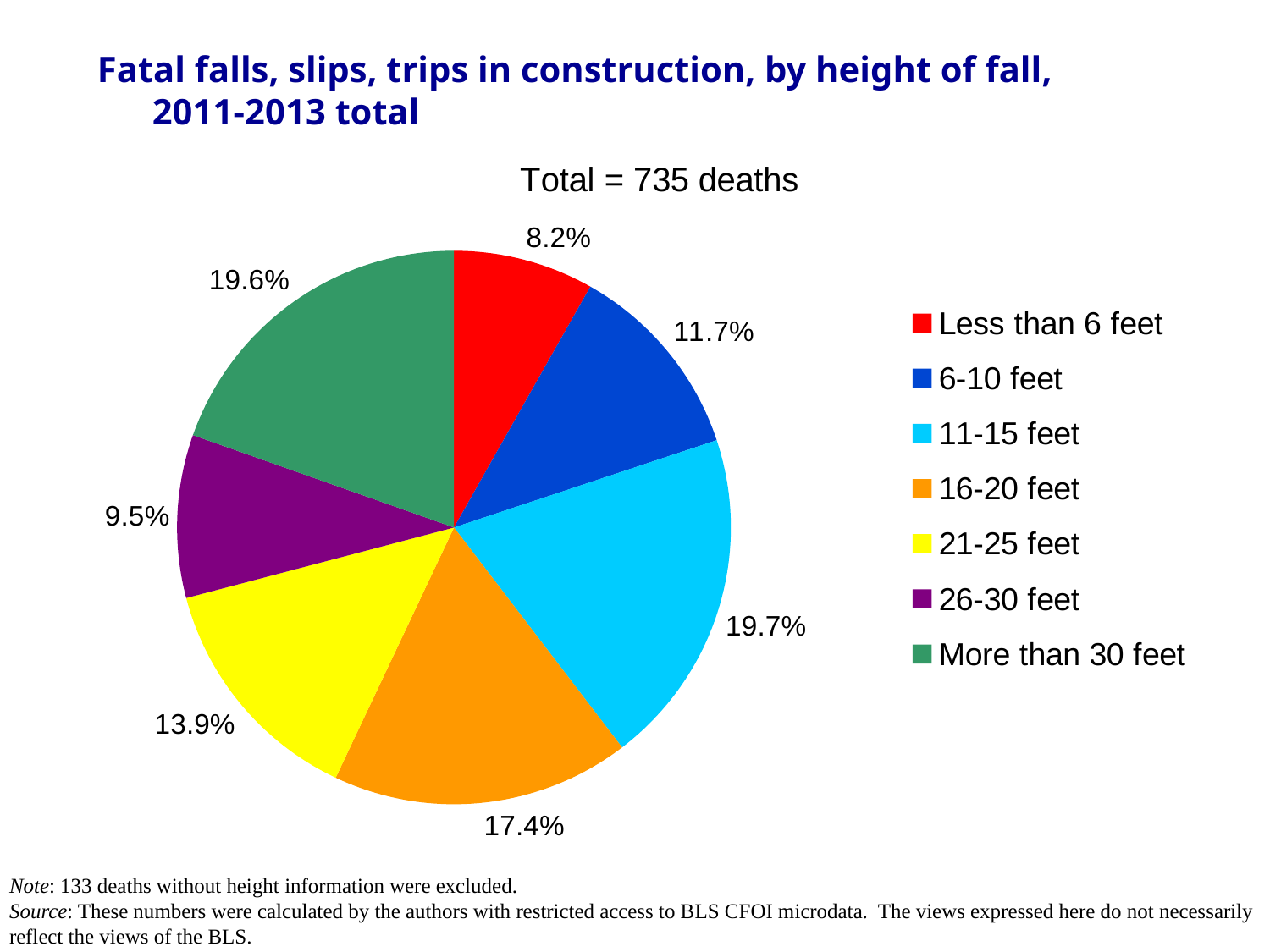
How many height categories does the pie chart show? 7 What percentage of fatal falls was from 11-15 feet? 19.7% Which colour represents the 21-25 feet category in the legend? Yellow What is the total number of deaths represented by the pie chart? 735 deaths Which height category has the smallest share of fatal falls? Less than 6 feet What share of fatal falls was from more than 30 feet? 19.6% How many percentage points larger is the 16-20 feet share than the 21-25 feet share? 3.5 percentage points What share of fatal falls was from less than 6 feet? 8.2% Which has a larger share of fatal falls: 21-25 feet or 6-10 feet? 21-25 feet What share of fatal falls was from 26-30 feet? 9.5% What percentage of fatal falls was from 16-20 feet? 17.4% What type of chart is shown on the slide? Pie chart